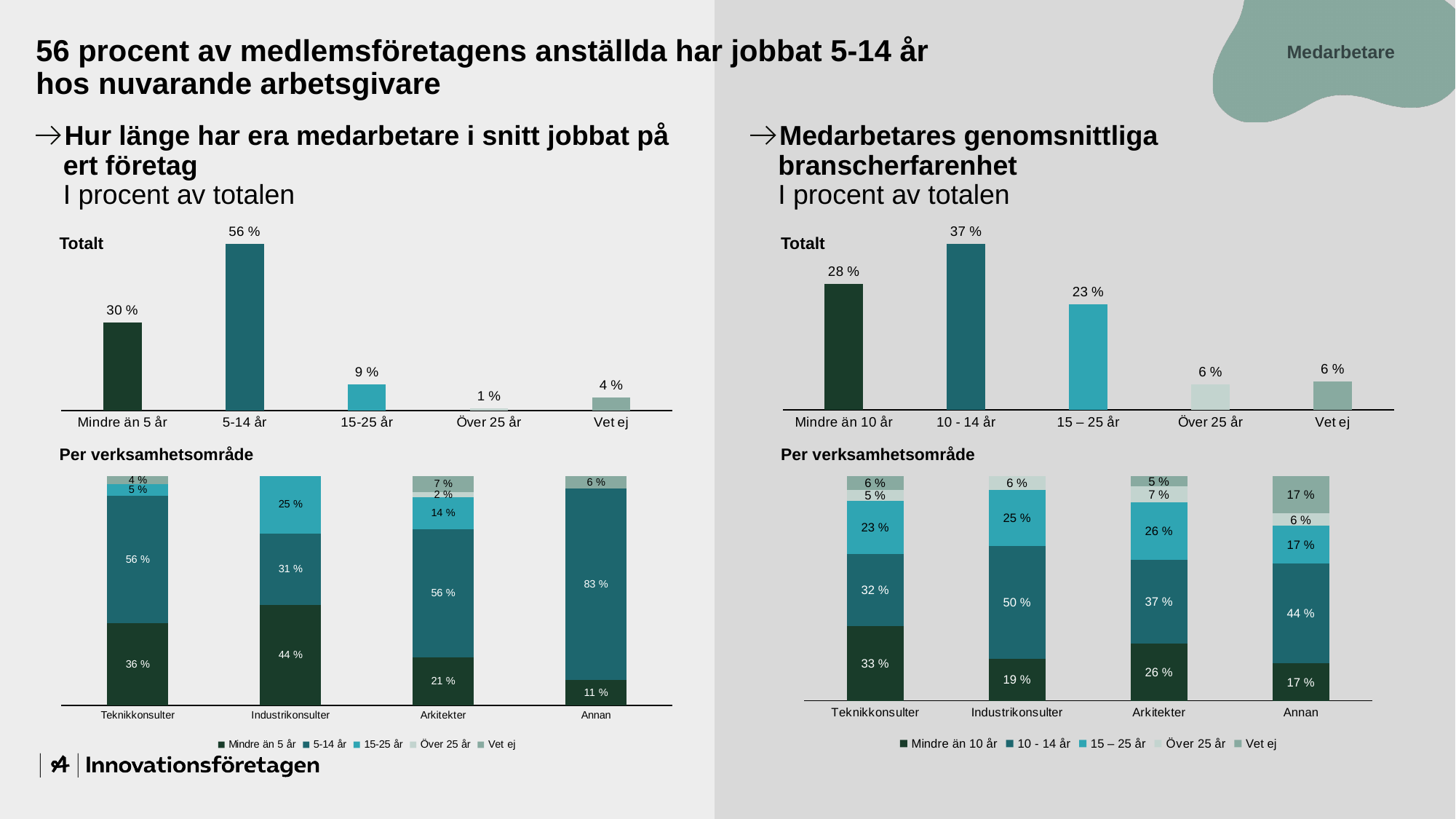
In the top-right 'Totalt' chart (Medarbetares genomsnittliga branscherfarenhet), which category has the highest value? 10 - 14 år In the top-right 'Totalt' chart (Medarbetares genomsnittliga branscherfarenhet), what is the value for 'Mindre än 10 år'? 28 % What type of chart is the bottom-right 'Per verksamhetsområde' chart? Stacked bar chart How many series does the legend of the bottom-right 'Per verksamhetsområde' stacked bar chart list? 5 In the bottom-left 'Per verksamhetsområde' stacked bar chart, what is the '5-14 år' value for 'Annan'? 83 % In the top-left 'Totalt' chart (Hur länge har era medarbetare i snitt jobbat på ert företag), what is the difference between '5-14 år' and 'Mindre än 5 år'? 26 % In the top-left 'Totalt' chart (Hur länge har era medarbetare i snitt jobbat på ert företag), what is the value for '5-14 år'? 56 % In the bottom-right 'Per verksamhetsområde' stacked bar chart, what is the '10 - 14 år' value for 'Industrikonsulter'? 50 % In the bottom-left 'Per verksamhetsområde' stacked bar chart, what is the 'Mindre än 5 år' value for 'Industrikonsulter'? 44 % In the top-left 'Totalt' chart (Hur länge har era medarbetare i snitt jobbat på ert företag), which category has the lowest value? Över 25 år In the top-right 'Totalt' chart (Medarbetares genomsnittliga branscherfarenhet), which is larger: '15 – 25 år' or 'Över 25 år'? 15 – 25 år How many categories are shown in the top-left 'Totalt' chart (Hur länge har era medarbetare i snitt jobbat på ert företag)? 5